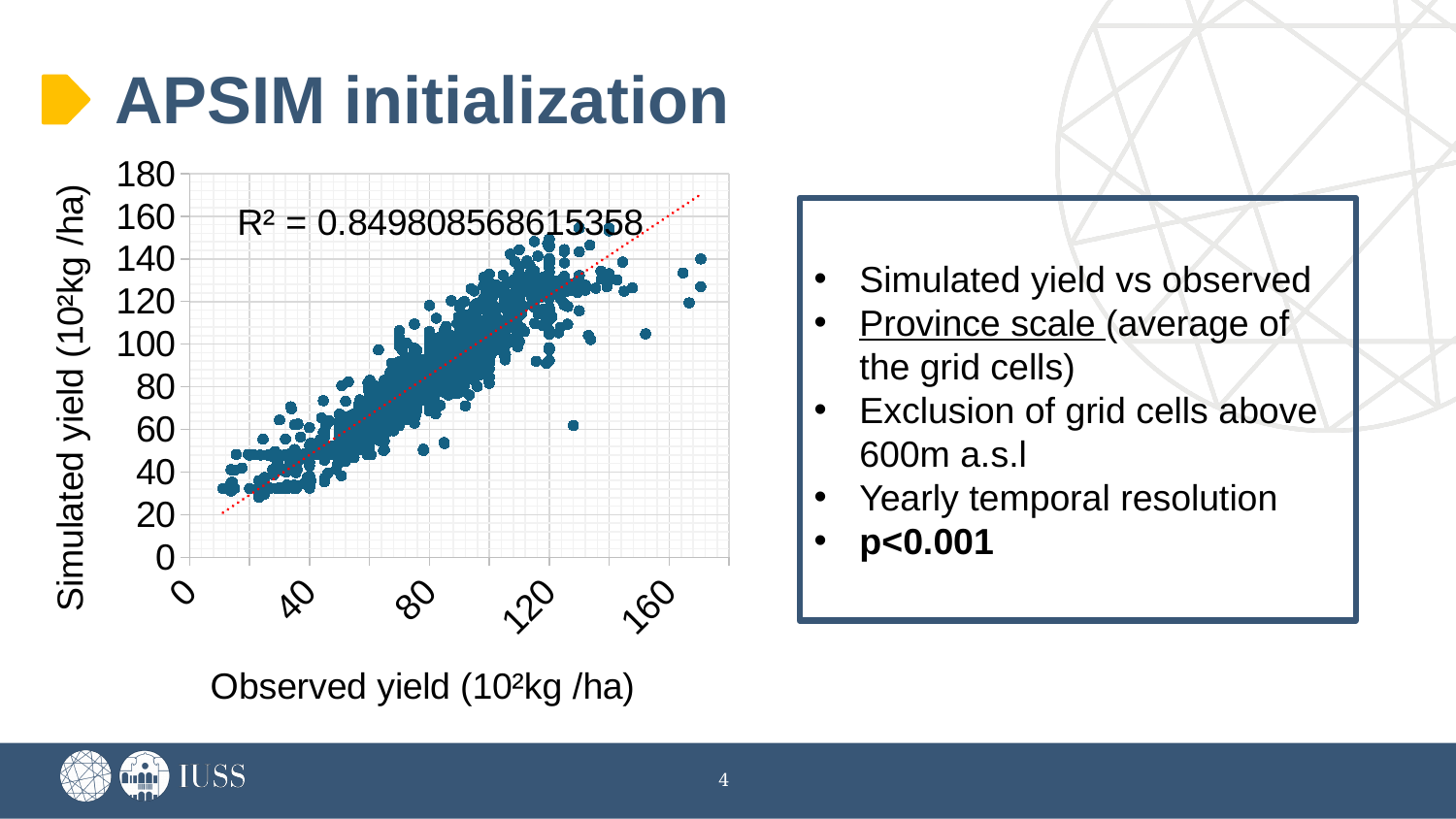
Is the largest observed yield value plotted greater or less than 160? greater What is the label of the y axis? Simulated yield (10²kg /ha) What R² value is printed on the chart? R² = 0.849808568615358 Is the lowest simulated yield value plotted greater or less than 20? greater As observed yield increases along the x axis, does simulated yield generally rise or fall? Rise Is the R² value shown on the chart greater or less than 0.8? greater What is the label of the x axis? Observed yield (10²kg /ha) What is the highest tick value labelled on the x axis? 160 What is the highest tick value shown on the y axis? 180 What kind of chart is shown on the slide? Scatter chart